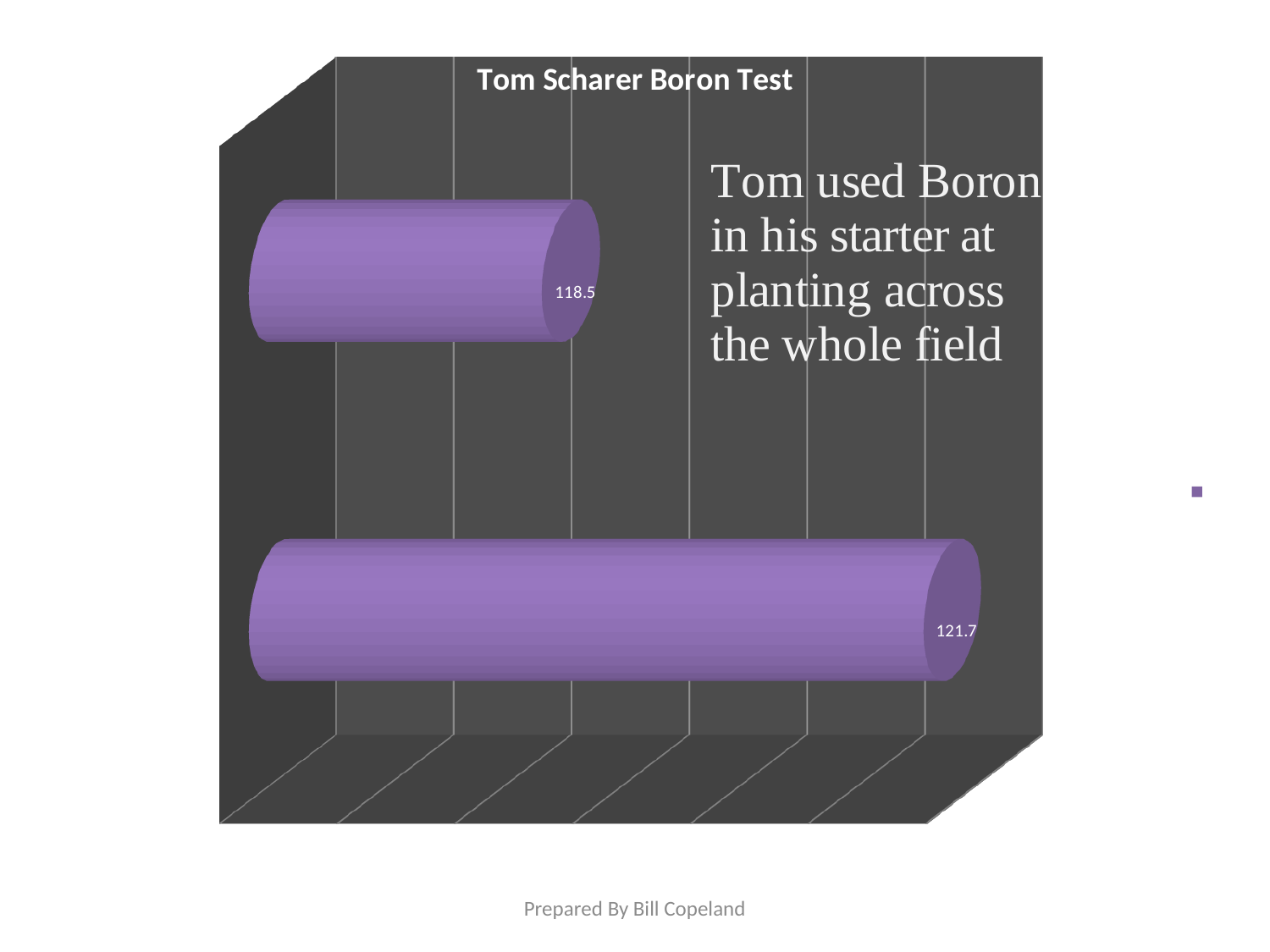
What is the title of the chart? Tom Scharer Boron Test What is the highest value shown in the chart? 121.7 What is the value shown on the top bar? 118.5 What is the lowest value shown in the chart? 118.5 What is the difference between the bottom bar's value and the top bar's value? 3.2 How many bars are plotted in the chart? 2 What kind of chart is shown on the slide? bar chart Which bar has the larger value, the top bar or the bottom bar? the bottom bar What is the value shown on the bottom bar? 121.7 What colour are the bars in the chart? purple